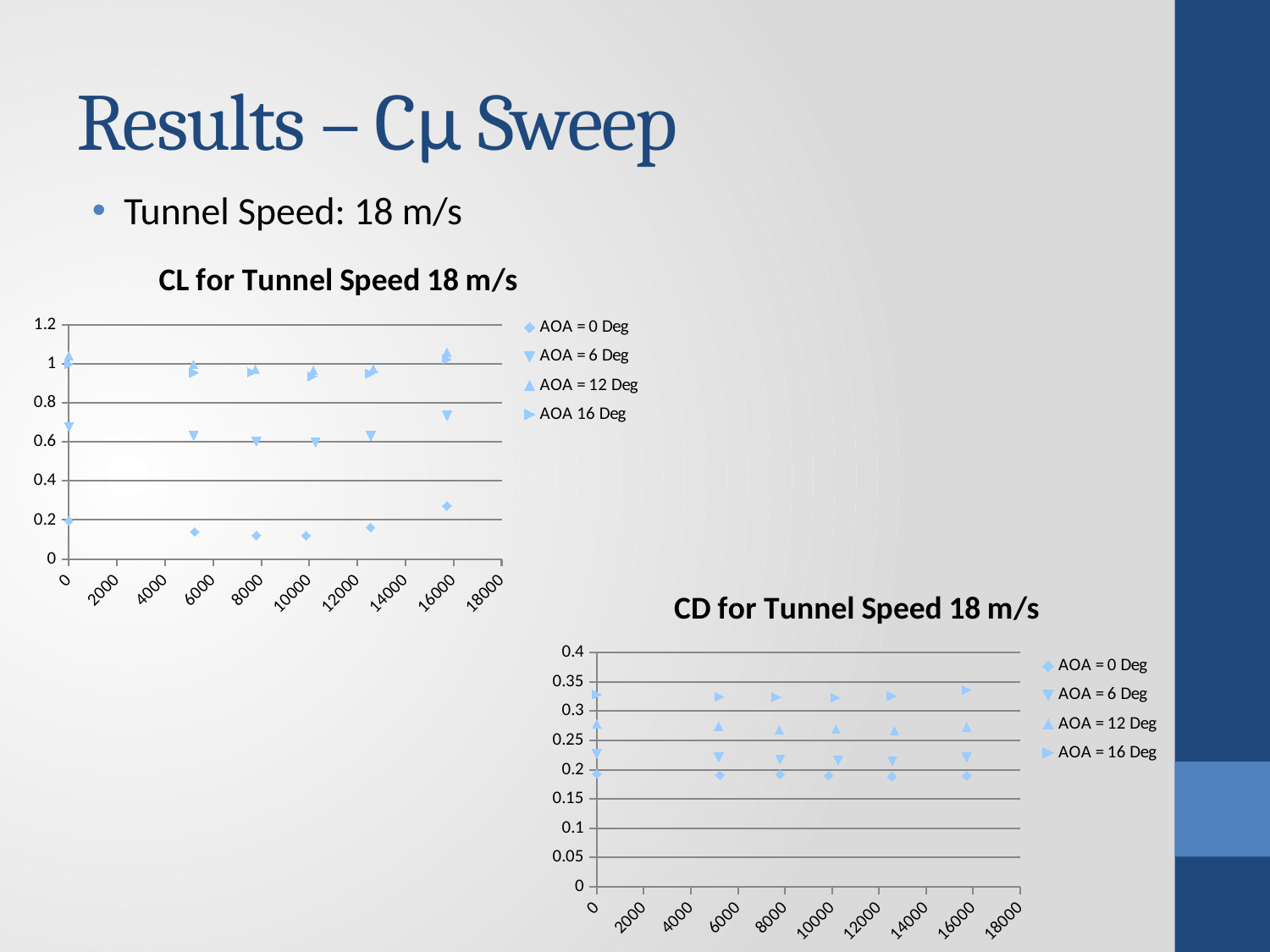
How many series does the legend of the 'CL for Tunnel Speed 18 m/s' chart list? 4 What is the title of the chart in the lower right of the slide? CD for Tunnel Speed 18 m/s In the 'CL for Tunnel Speed 18 m/s' chart, is the value for AOA = 0 Deg at x = 8000 greater or less than 0.2? less In the 'CD for Tunnel Speed 18 m/s' chart, which series has the lowest values across the x axis? AOA = 0 Deg In the 'CL for Tunnel Speed 18 m/s' chart, is the value for AOA = 6 Deg at x = 16000 greater or less than 0.6? greater In the 'CL for Tunnel Speed 18 m/s' chart, which series has larger values at x = 16000, AOA = 6 Deg or AOA = 0 Deg? AOA = 6 Deg How many series does the legend of the 'CD for Tunnel Speed 18 m/s' chart list? 4 In the 'CD for Tunnel Speed 18 m/s' chart, which series has larger values at x = 10000, AOA = 16 Deg or AOA = 0 Deg? AOA = 16 Deg In the 'CD for Tunnel Speed 18 m/s' chart, is the value for AOA = 16 Deg at x = 16000 greater or less than 0.3? greater What kind of chart is the 'CL for Tunnel Speed 18 m/s' chart? scatter chart How many data points does the AOA = 0 Deg series have in the 'CD for Tunnel Speed 18 m/s' chart? 6